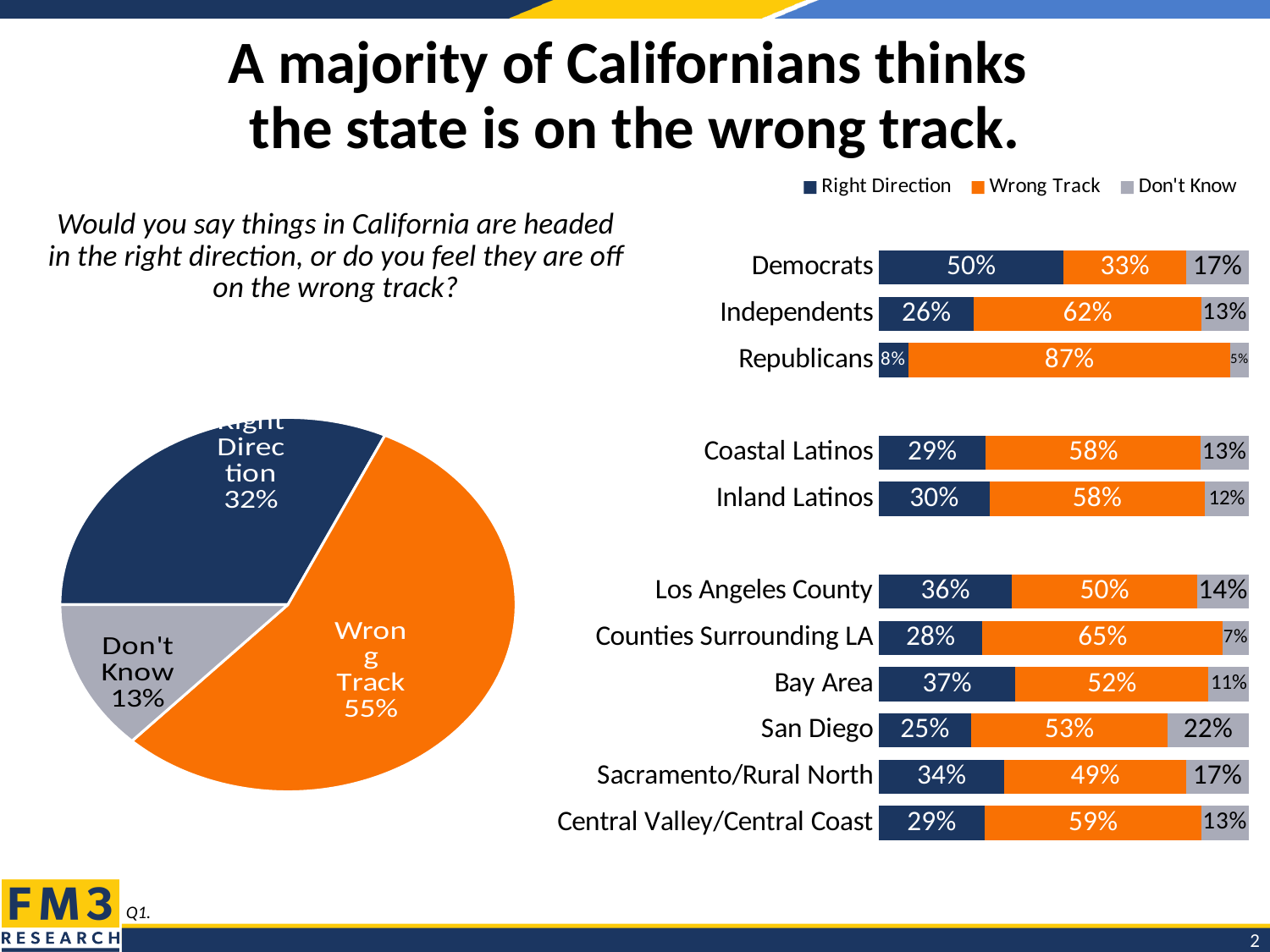
In the bar chart on the right, what is the Don't Know value for San Diego? 22% How many series does the legend of the bar chart on the right list? 3 In the pie chart on the left, which response has the largest slice? Wrong Track In the bar chart on the right, which group has the lowest Right Direction value? Republicans In the bar chart on the right, what is the Right Direction value for Democrats? 50% In the pie chart on the left, what share of respondents said Don't Know? 13% In the pie chart on the left, what share of respondents said Wrong Track? 55% In the bar chart on the right, which has a higher Right Direction value, Bay Area or Los Angeles County? Bay Area How many groups are shown in the bar chart on the right? 11 In the bar chart on the right, which group has the highest Wrong Track value? Republicans In the bar chart on the right, what is the Wrong Track value for Republicans? 87% In the bar chart on the right, what is the difference between the Wrong Track values for Independents and Democrats? 29%